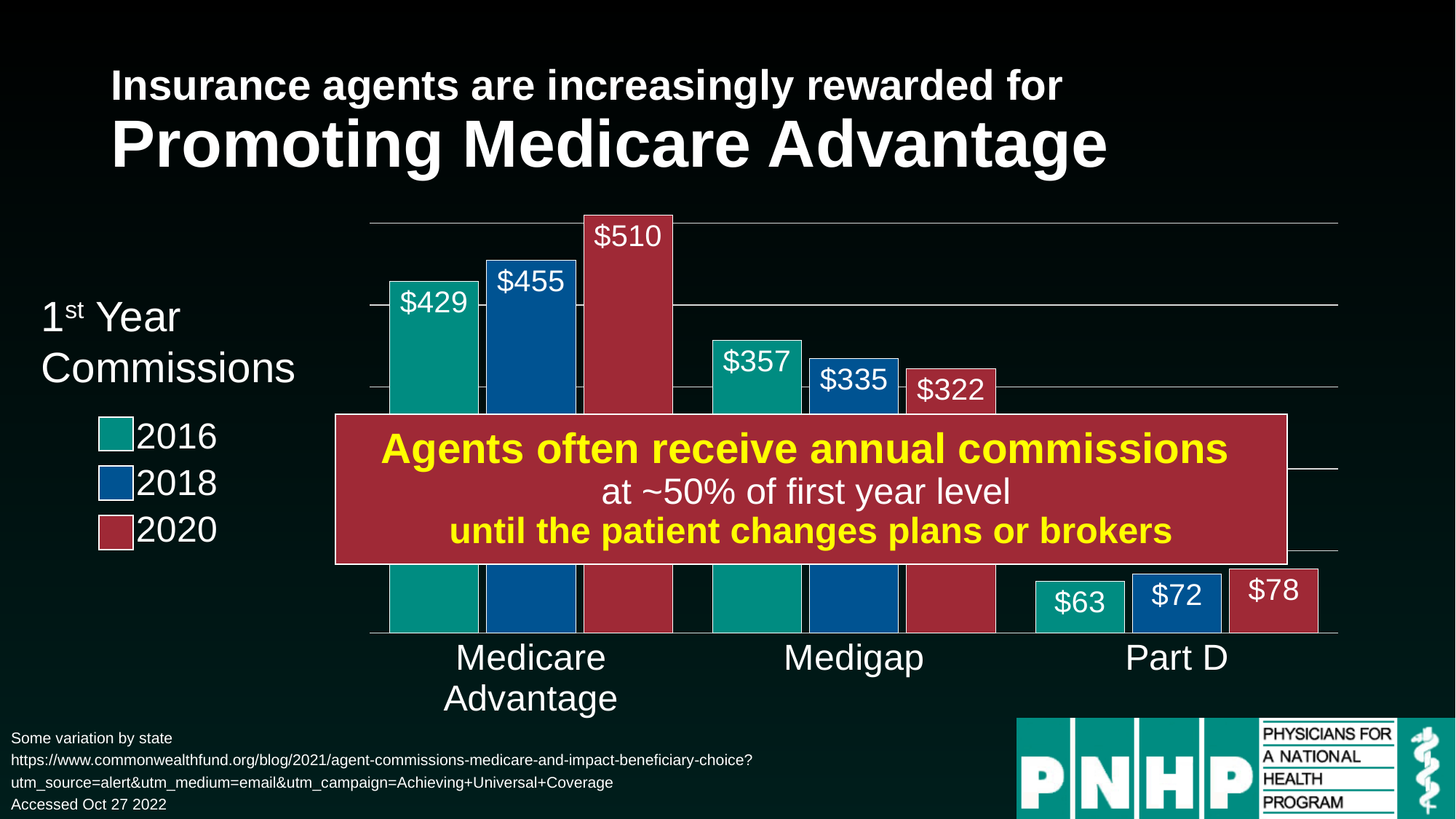
How much did the Medicare Advantage 1st year commission increase from 2016 to 2020? $81 What was the 1st year commission for Part D in 2018? $72 Did the Medigap 1st year commission rise or fall from 2016 to 2020? Fall How many plan types are shown on the x axis? 3 What kind of chart is shown on the slide? Bar chart What was the 1st year commission for Medicare Advantage in 2020? $510 What is the difference between the 2016 and 2020 Medigap 1st year commissions? $35 What was the 1st year commission for Medigap in 2016? $357 How many years does the legend list? 3 Which plan type had the lowest 1st year commission in 2016? Part D Which was larger, the 2018 Medigap commission or the 2018 Medicare Advantage commission? 2018 Medicare Advantage Which plan type had the highest 1st year commission in 2020? Medicare Advantage